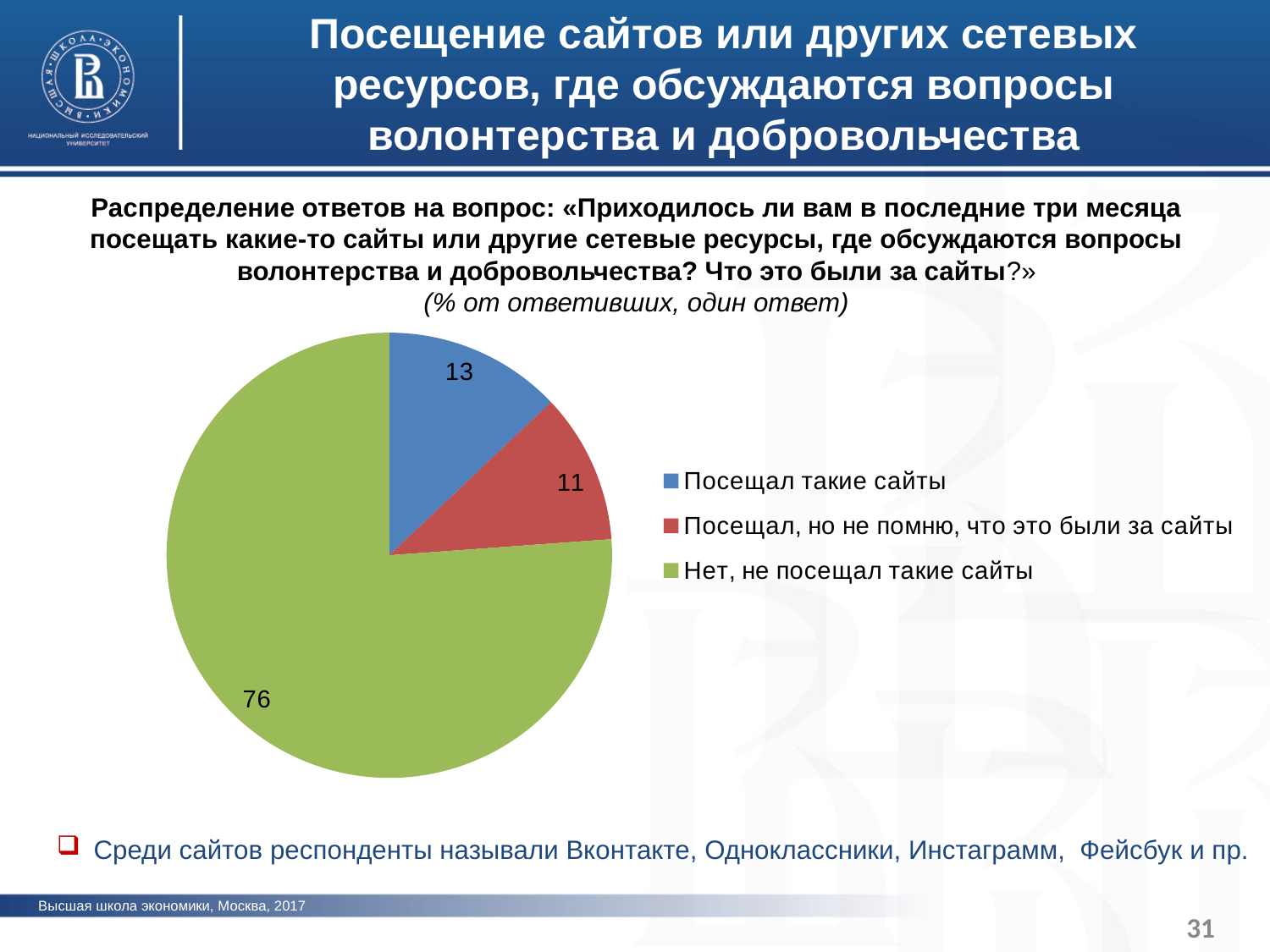
How many categories does the pie chart have? 3 What colour is the slice for «Нет, не посещал такие сайты»? green What kind of chart is shown on the slide? pie chart What is the value for «Посещал, но не помню, что это были за сайты»? 11 What is the difference between the values for «Нет, не посещал такие сайты» and «Посещал такие сайты»? 63 Which category has the largest slice of the pie? Нет, не посещал такие сайты Which is larger: the value for «Посещал такие сайты» or for «Нет, не посещал такие сайты»? Нет, не посещал такие сайты Which category has the smallest slice of the pie? Посещал, но не помню, что это были за сайты What is the difference between the values for «Посещал такие сайты» and «Посещал, но не помню, что это были за сайты»? 2 What is the value for «Нет, не посещал такие сайты»? 76 What colour is the slice for «Посещал такие сайты»? blue What is the value for «Посещал такие сайты»? 13